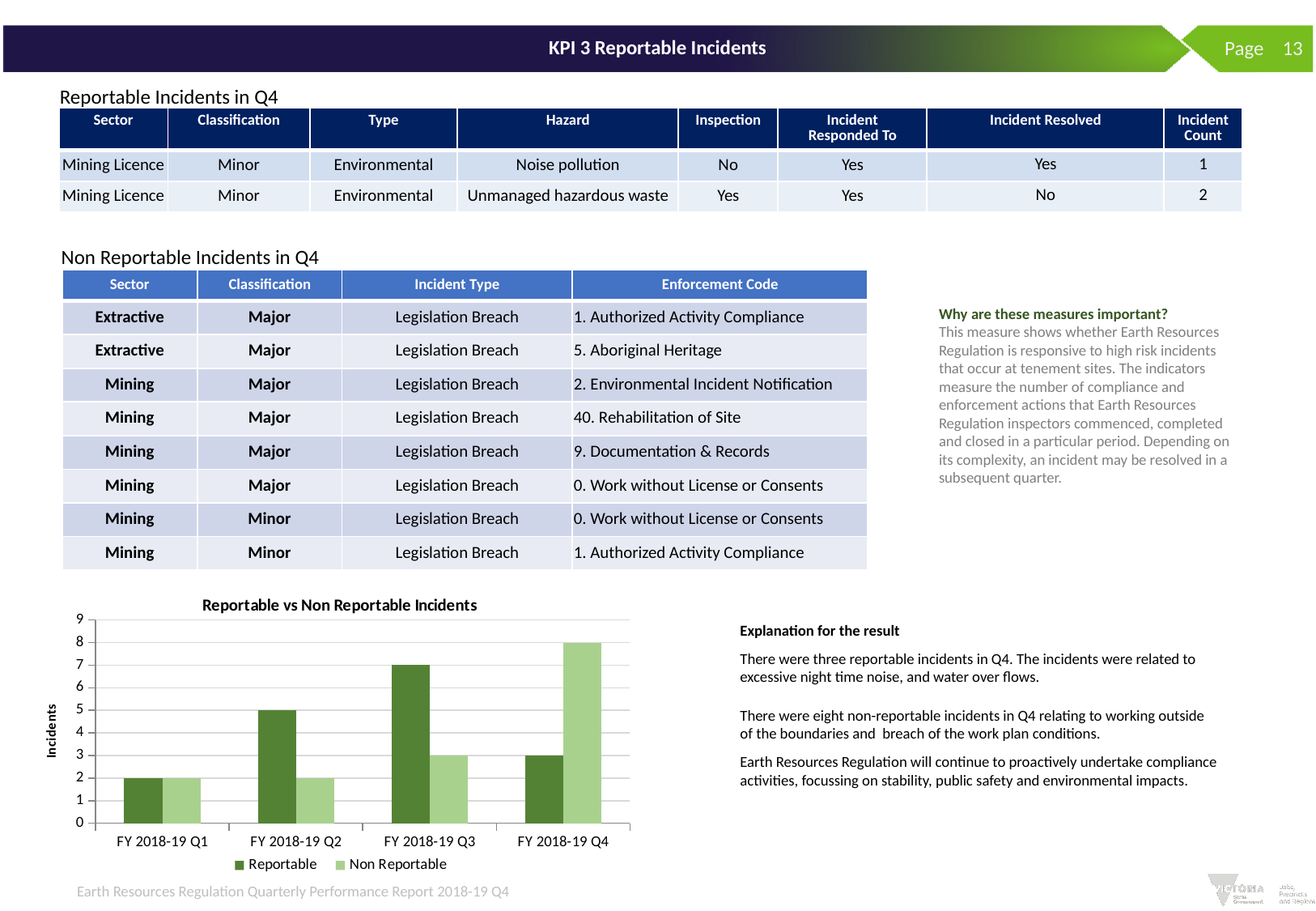
In the 'Reportable vs Non Reportable Incidents' chart, what is the Non Reportable value for FY 2018-19 Q4? 8 In the 'Reportable vs Non Reportable Incidents' chart, what is the Reportable value for FY 2018-19 Q3? 7 In the 'Reportable vs Non Reportable Incidents' chart, is the Non Reportable bar for FY 2018-19 Q3 greater or less than 5? less How many quarters are shown on the x axis of the 'Reportable vs Non Reportable Incidents' chart? 4 In the 'Reportable vs Non Reportable Incidents' chart, which quarter has the highest Reportable value? FY 2018-19 Q3 How many series does the legend of the 'Reportable vs Non Reportable Incidents' chart list? 2 What is the label on the vertical axis of the 'Reportable vs Non Reportable Incidents' chart? Incidents In the 'Reportable vs Non Reportable Incidents' chart, which is larger for FY 2018-19 Q2: Reportable or Non Reportable? Reportable In the 'Reportable vs Non Reportable Incidents' chart, which is larger for FY 2018-19 Q4: Reportable or Non Reportable? Non Reportable What kind of chart is 'Reportable vs Non Reportable Incidents'? bar chart In the 'Reportable vs Non Reportable Incidents' chart, which quarter has the highest Non Reportable value? FY 2018-19 Q4 In the 'Reportable vs Non Reportable Incidents' chart, is the Reportable bar for FY 2018-19 Q2 greater or less than 4? greater